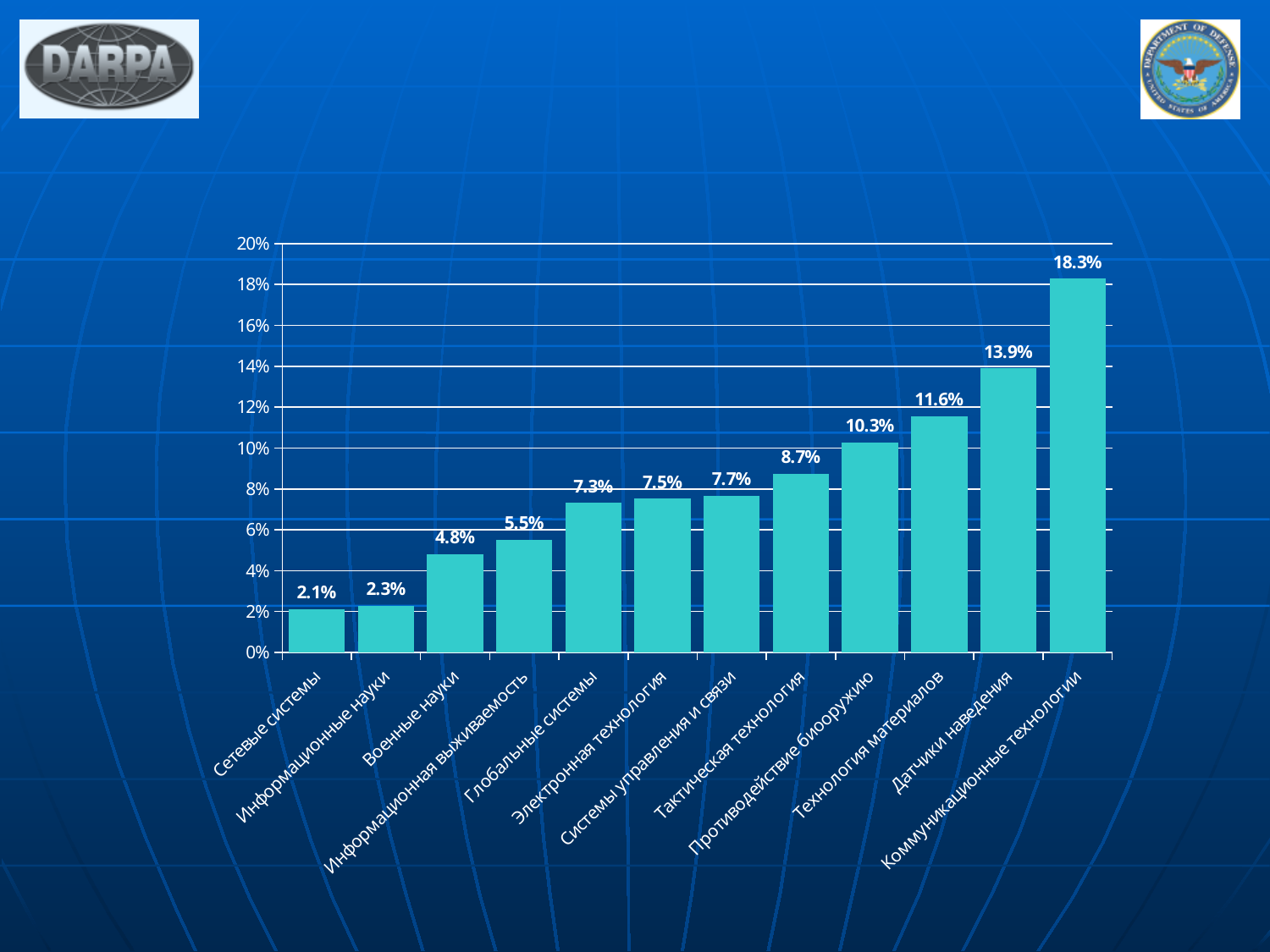
Which category has the lowest value? Сетевые системы What is the value for Системы управления и связи? 7.7% What is the value for Военные науки? 4.8% Is the value for Глобальные системы greater or less than 6%? greater What is the value for Противодействие биооружию? 10.3% Which category has the highest value? Коммуникационные технологии What kind of chart is shown on the slide? bar chart What is the value for Коммуникационные технологии? 18.3% How many categories are shown on the chart? 12 Do the values rise or fall from left to right along the x axis? rise What is the difference between the values for Датчики наведения and Технология материалов? 2.3% Which is larger, the value for Тактическая технология or the value for Информационная выживаемость? Тактическая технология